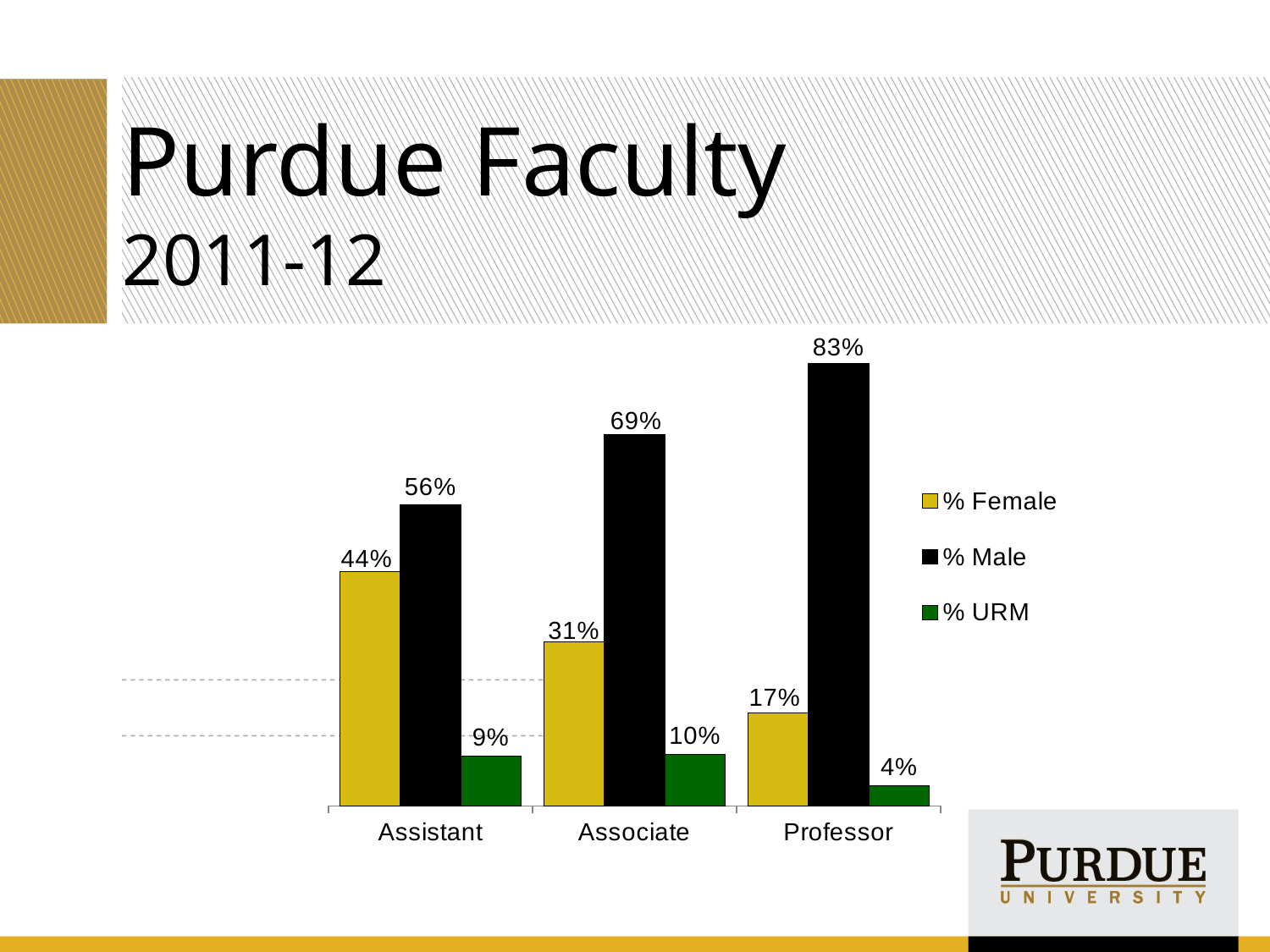
Which category has the highest % Male value? Professor Which category has the lowest % URM value? Professor How many categories are shown on the x axis? 3 How many series does the legend list? 3 What is the difference between the % Male and % Female values for Associate? 38% What is the % URM value for Associate? 10% What colour are the % Male bars? black What kind of chart is shown on the slide? bar chart Which is larger, the % Female value for Assistant or the % Female value for Professor? Assistant What is the % Male value for Professor? 83% What is the % Female value for Assistant? 44% Does the % Female value rise or fall from Assistant to Professor? fall